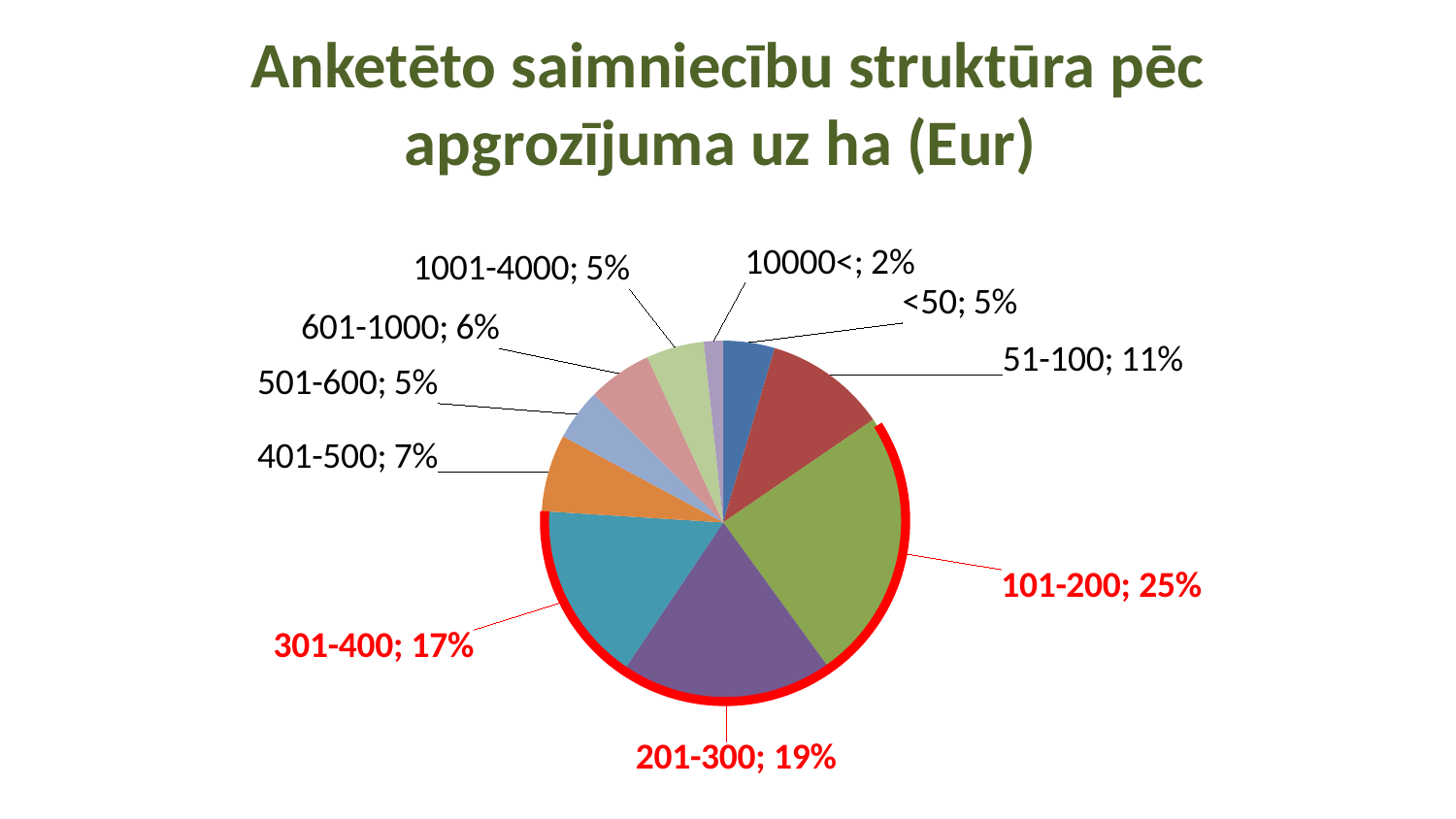
What is the difference between the shares of the 101-200 and 301-400 categories? 8% How many categories are shown in the pie chart? 10 What is the value shown for the 201-300 category? 19% What share of the pie does the 101-200 category have? 25% Which category has the smallest share of the pie? 10000< What is the combined share of the three categories highlighted in red (101-200, 201-300, 301-400)? 61% What is the value shown for the 51-100 category? 11% What is the title of the chart? Anketēto saimniecību struktūra pēc apgrozījuma uz ha (Eur) Which category has a larger share: 601-1000 or 401-500? 401-500 What is the value shown for the 401-500 category? 7% Which category has the largest share of the pie? 101-200 What type of chart is shown on the slide? pie chart